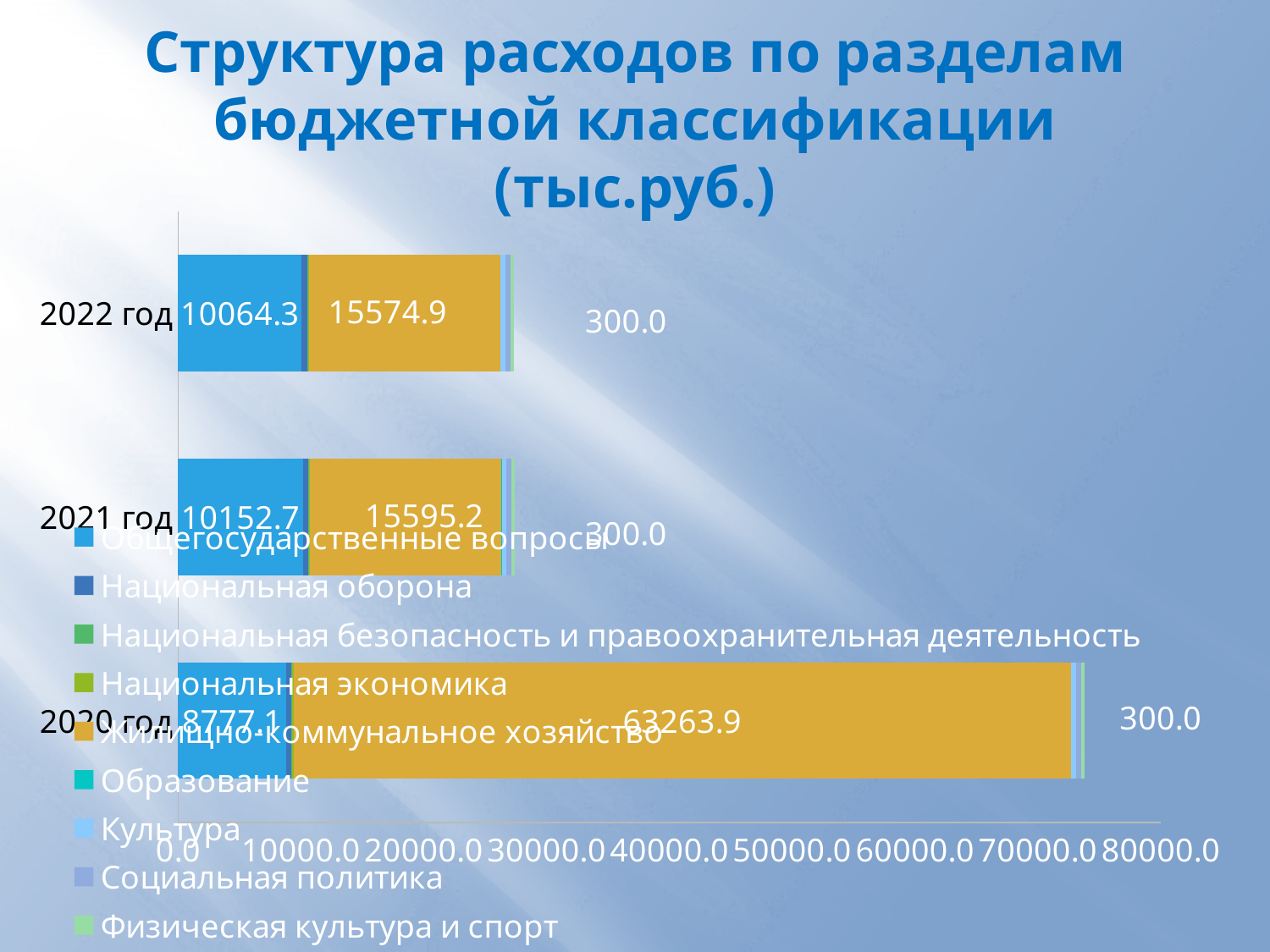
What is the value for Жилищно-коммунальное хозяйство in 2021 год? 15595.2 What is the value for Жилищно-коммунальное хозяйство in 2020 год? 63263.9 Is the total length of the stacked bar for 2020 год greater or less than 70000.0? greater What is the value for Общегосударственные вопросы in 2020 год? 8777.1 Which is larger: Общегосударственные вопросы in 2021 год or in 2022 год? 2021 год In which year is the value for Общегосударственные вопросы the lowest? 2020 год What is the difference between the Жилищно-коммунальное хозяйство values for 2020 год and 2022 год? 47689.0 How many series does the legend list? 9 What kind of chart is shown on the slide? Stacked bar chart How many years (categories) are shown on the chart? 3 In which year is the value for Жилищно-коммунальное хозяйство the highest? 2020 год What is the value for Общегосударственные вопросы in 2022 год? 10064.3